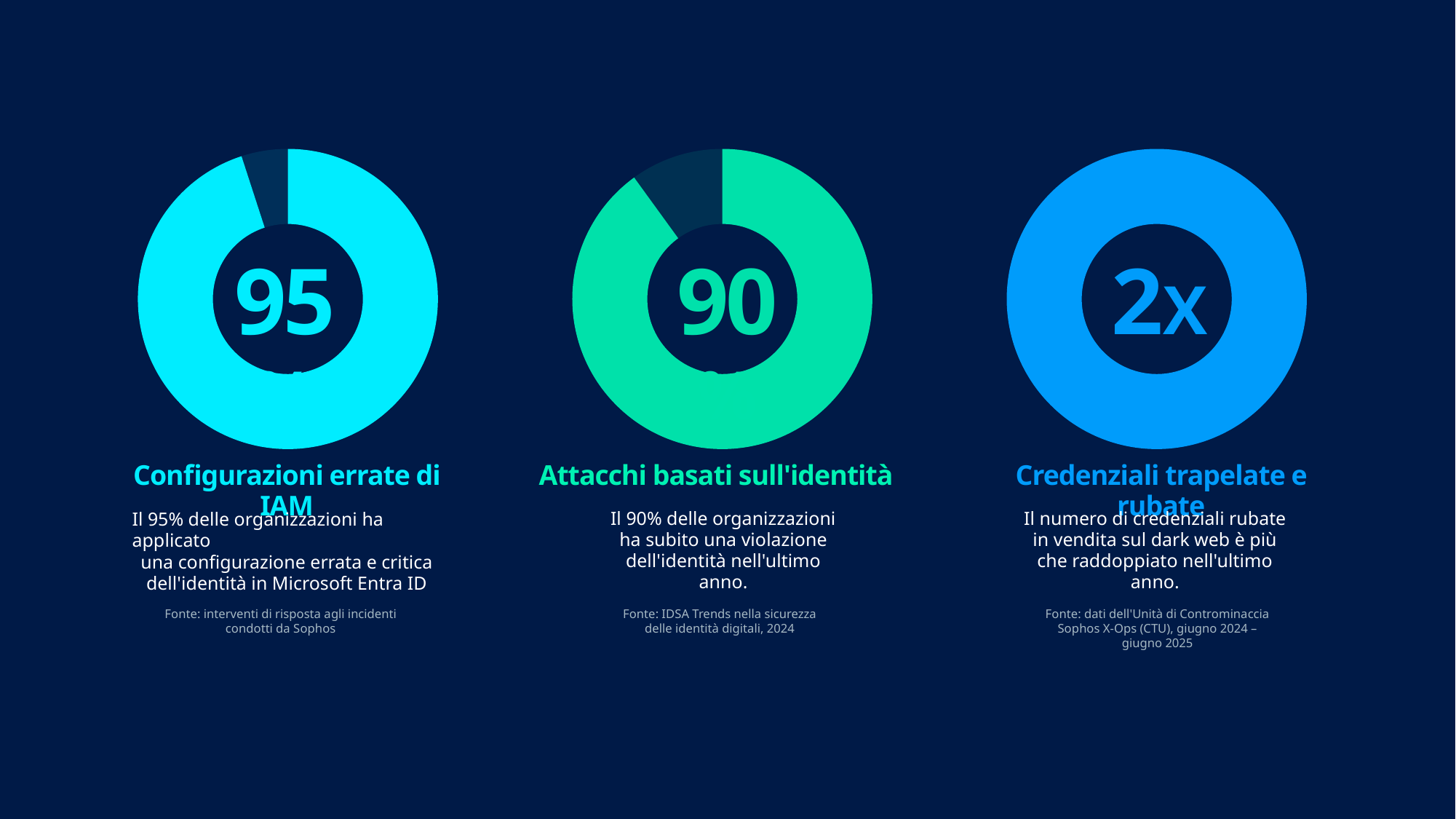
How many donut charts are shown on the slide? 3 Of the two percentage donut charts, which one has the larger filled share? Configurazioni errate di IAM In the 'Configurazioni errate di IAM' donut chart, what share of the ring is filled in cyan? 95% What is the title of the rightmost chart on the slide? Credenziali trapelate e rubate Which shows a higher percentage: the 'Configurazioni errate di IAM' chart or the 'Attacchi basati sull'identità' chart? Configurazioni errate di IAM In the 'Credenziali trapelate e rubate' chart, what value is shown in the centre? 2x What kind of chart is used for the 'Configurazioni errate di IAM' figure? Donut (pie) chart What is the difference between the percentage in the 'Configurazioni errate di IAM' chart and the percentage in the 'Attacchi basati sull'identità' chart? 5 percentage points What colour is the filled ring of the 'Attacchi basati sull'identità' donut chart? Green In the 'Attacchi basati sull'identità' donut chart, what percentage is shown? 90% In the 'Configurazioni errate di IAM' donut chart, what percentage is shown? 95%